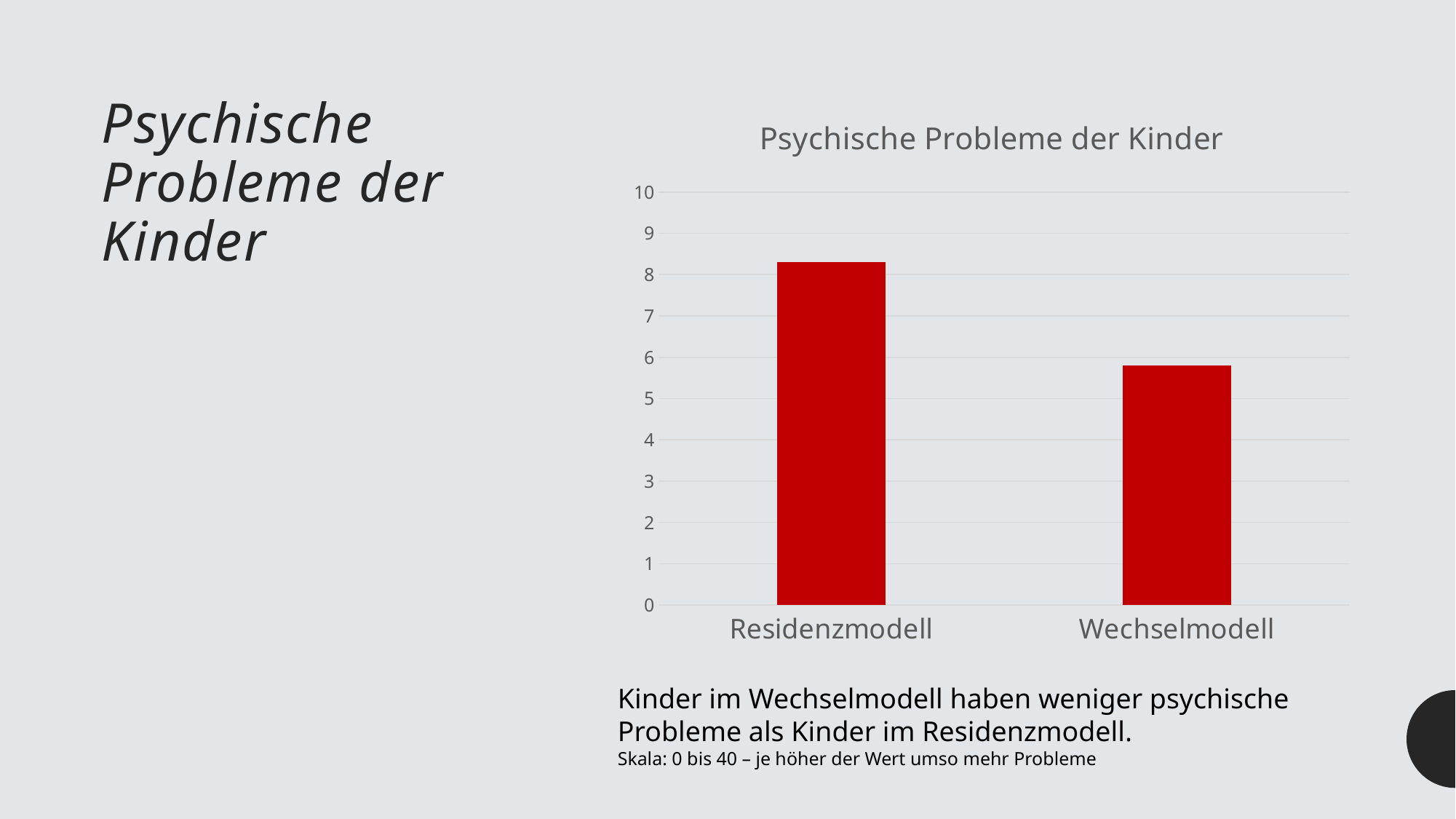
Is the value for Wechselmodell greater or less than 7? less Which is larger, the value for Residenzmodell or the value for Wechselmodell? Residenzmodell Which category has the highest value in the chart? Residenzmodell Is the value for Residenzmodell greater or less than 7? greater Is the value for Wechselmodell greater or less than 5? greater How many categories are shown on the x axis of the chart? 2 What is the maximum value shown on the y axis of the chart? 10 Which category has the lowest value in the chart? Wechselmodell What is the title of the chart? Psychische Probleme der Kinder What kind of chart is shown on the slide? bar chart Do the values rise or fall from Residenzmodell to Wechselmodell along the x axis? fall